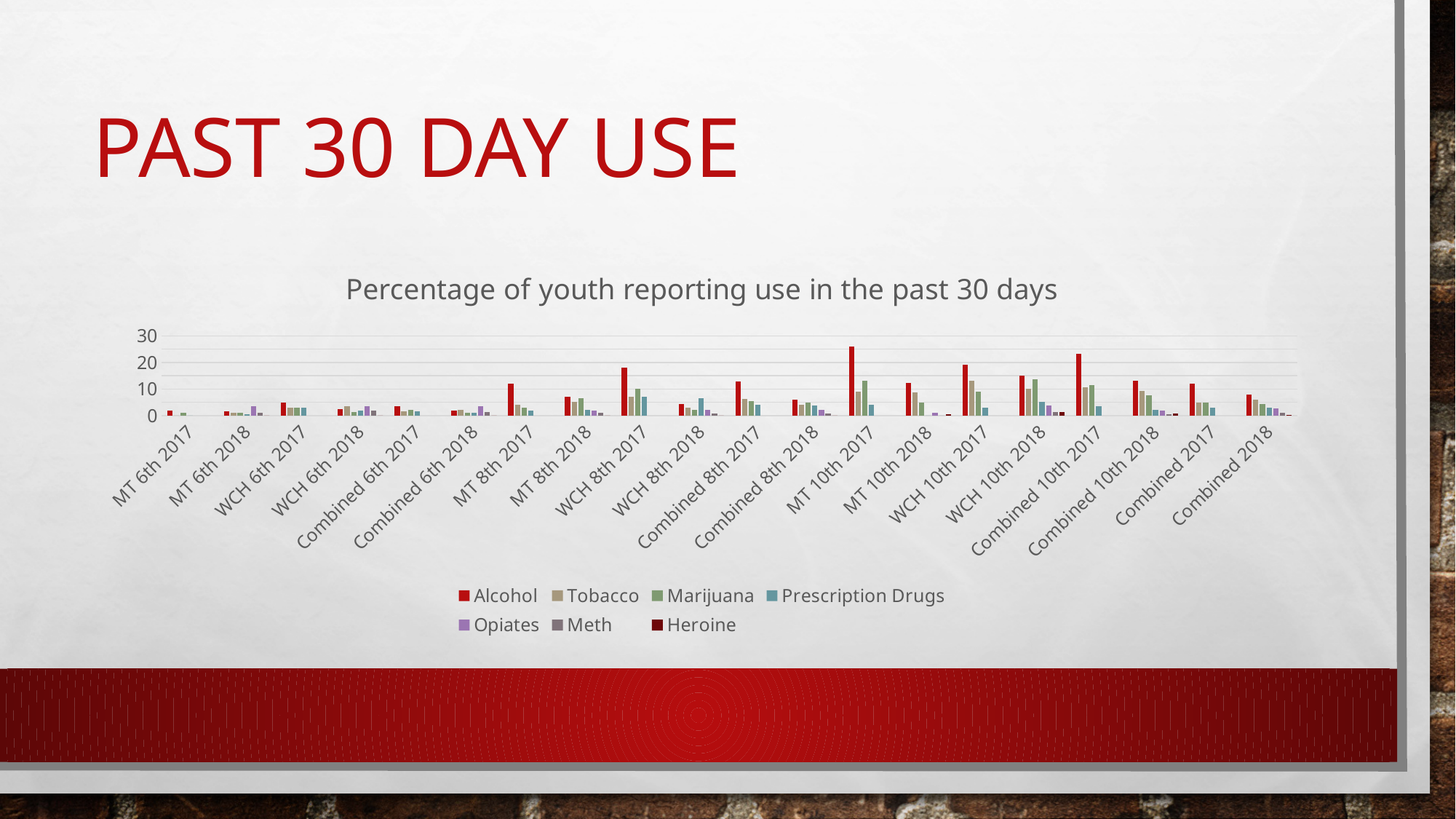
How many series does the legend list? 7 Is the Alcohol value for MT 6th 2017 greater or less than 10? less Is the Alcohol value for WCH 8th 2017 greater or less than 10? greater Which category has the highest Alcohol value? MT 10th 2017 Which is larger, the Alcohol value for WCH 8th 2017 or for WCH 8th 2018? WCH 8th 2017 What is the title of the chart? Percentage of youth reporting use in the past 30 days Which is larger, the Alcohol value for MT 10th 2017 or for MT 10th 2018? MT 10th 2017 How many categories are shown along the x axis? 20 What kind of chart is shown on the slide? bar chart Is the Alcohol value for Combined 10th 2017 greater or less than 20? greater Which series is listed first in the legend? Alcohol